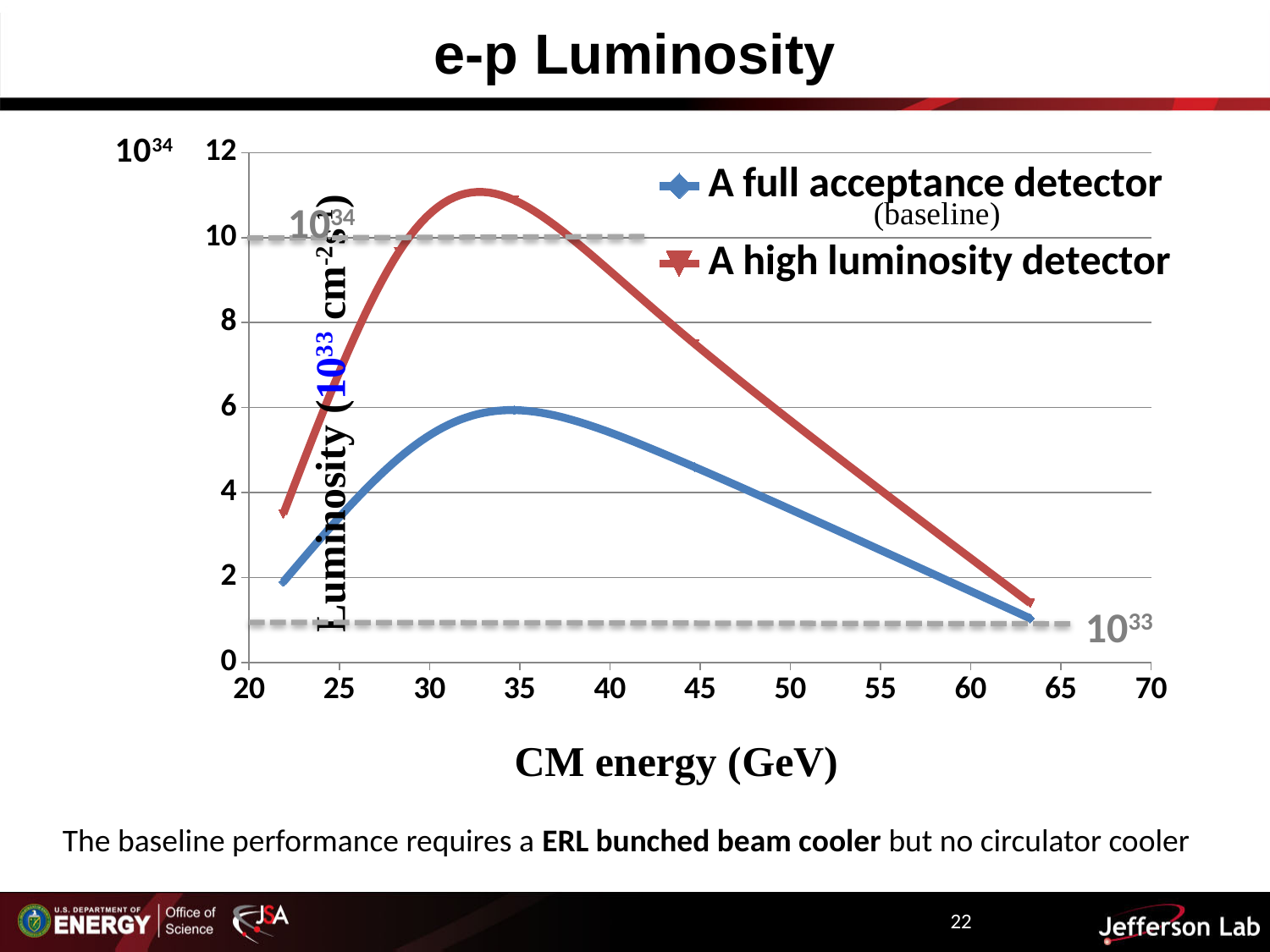
Is the peak value of the full acceptance detector curve greater or less than 4? greater Do the luminosity values rise or fall as CM energy increases from 20 GeV to 30 GeV? rise What kind of chart is shown on the slide? line chart Is the peak value of the high luminosity detector curve greater or less than 10? greater At a CM energy of 45 GeV, which series has the higher luminosity? A high luminosity detector How many series does the legend list? 2 How many labelled tick marks are on the x axis? 11 Which series is drawn in red? A high luminosity detector What is the title of the x axis? CM energy (GeV) Is the peak value of the full acceptance detector curve greater or less than 8? less Do the luminosity values rise or fall as CM energy increases from 40 GeV to 60 GeV? fall